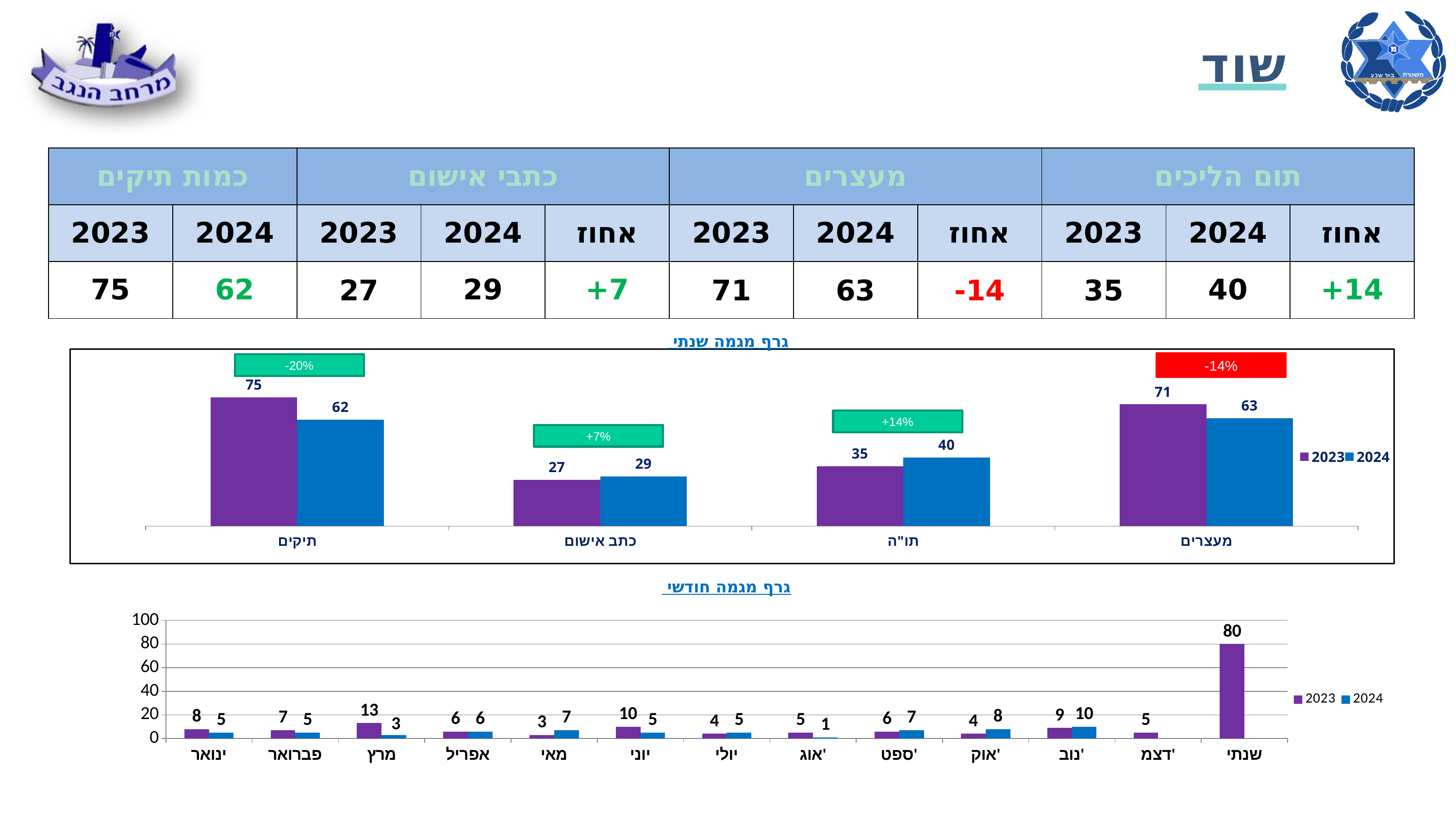
In the monthly trend chart (גרף מגמה חודשי), what is the 2024 value for אוק'? 8 In the annual trend chart (גרף מגמה שנתי), which category has the highest 2023 value? תיקים What kind of chart is the monthly trend chart (גרף מגמה חודשי)? bar chart In the annual trend chart (גרף מגמה שנתי), what is the 2023 value for תיקים? 75 In the monthly trend chart (גרף מגמה חודשי), how many categories are shown on the x axis? 13 In the monthly trend chart (גרף מגמה חודשי), which is larger for מאי: the 2023 value or the 2024 value? 2024 In the annual trend chart (גרף מגמה שנתי), which category has the lowest 2024 value? כתב אישום In the annual trend chart (גרף מגמה שנתי), how many series does the legend list? 2 In the monthly trend chart (גרף מגמה חודשי), what is the 2023 value for מרץ? 13 In the annual trend chart (גרף מגמה שנתי), what is the 2024 value for מעצרים? 63 In the monthly trend chart (גרף מגמה חודשי), what is the 2023 value for שנתי? 80 In the annual trend chart (גרף מגמה שנתי), what is the difference between the 2023 and 2024 values for תו"ה? 5